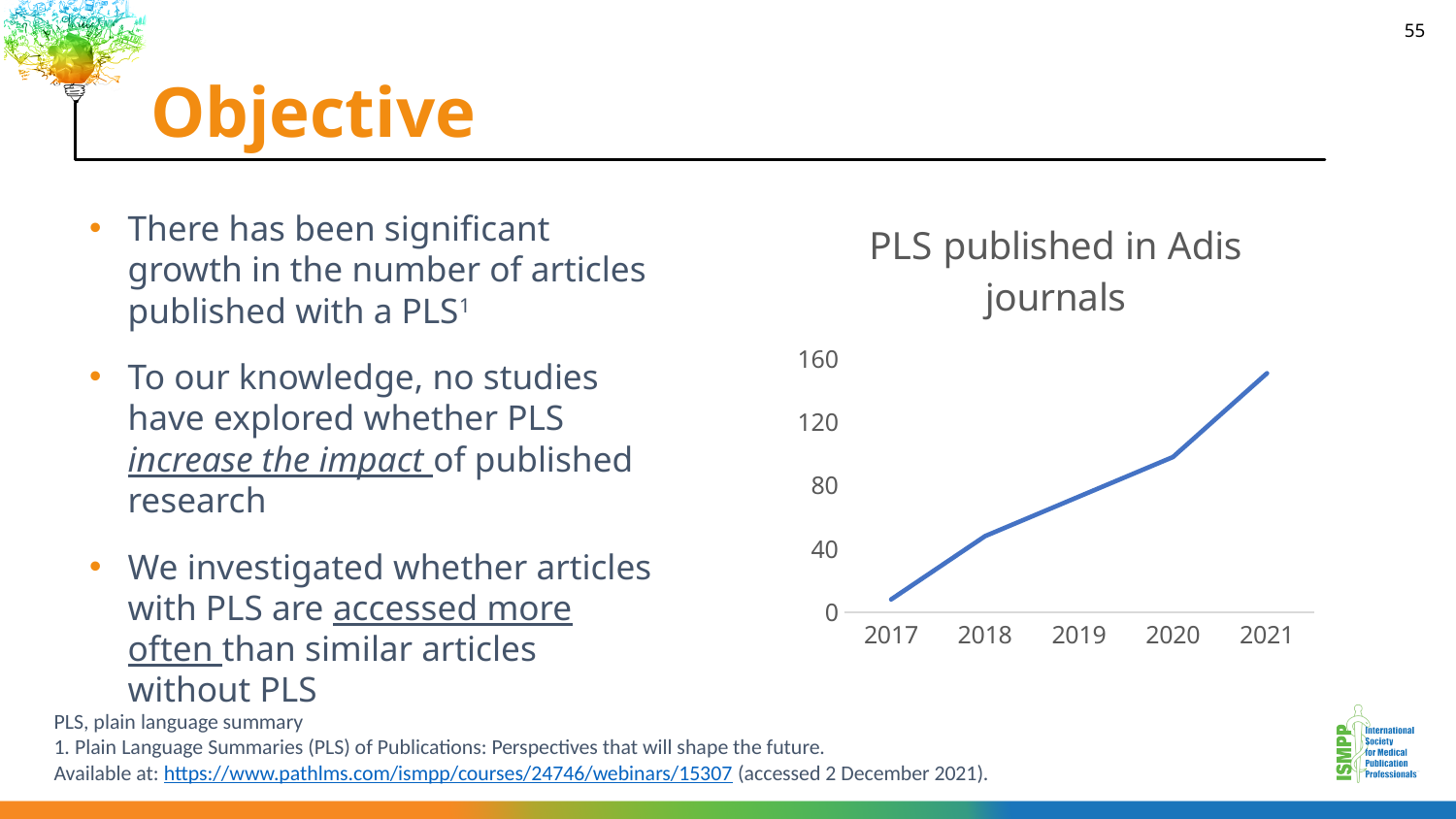
Which year has a larger value, 2018 or 2021? 2021 Is the value for 2020 greater or less than 80? greater Which year has the lowest number of PLS published in Adis journals? 2017 How many years are plotted on the x axis of the chart? 5 Is the value for 2019 greater or less than 40? greater Is the value for 2017 greater or less than 40? less Which year has the highest number of PLS published in Adis journals? 2021 Do the values rise or fall from 2017 to 2021? rise What kind of chart is shown on the slide? line chart What is the title of the chart? PLS published in Adis journals